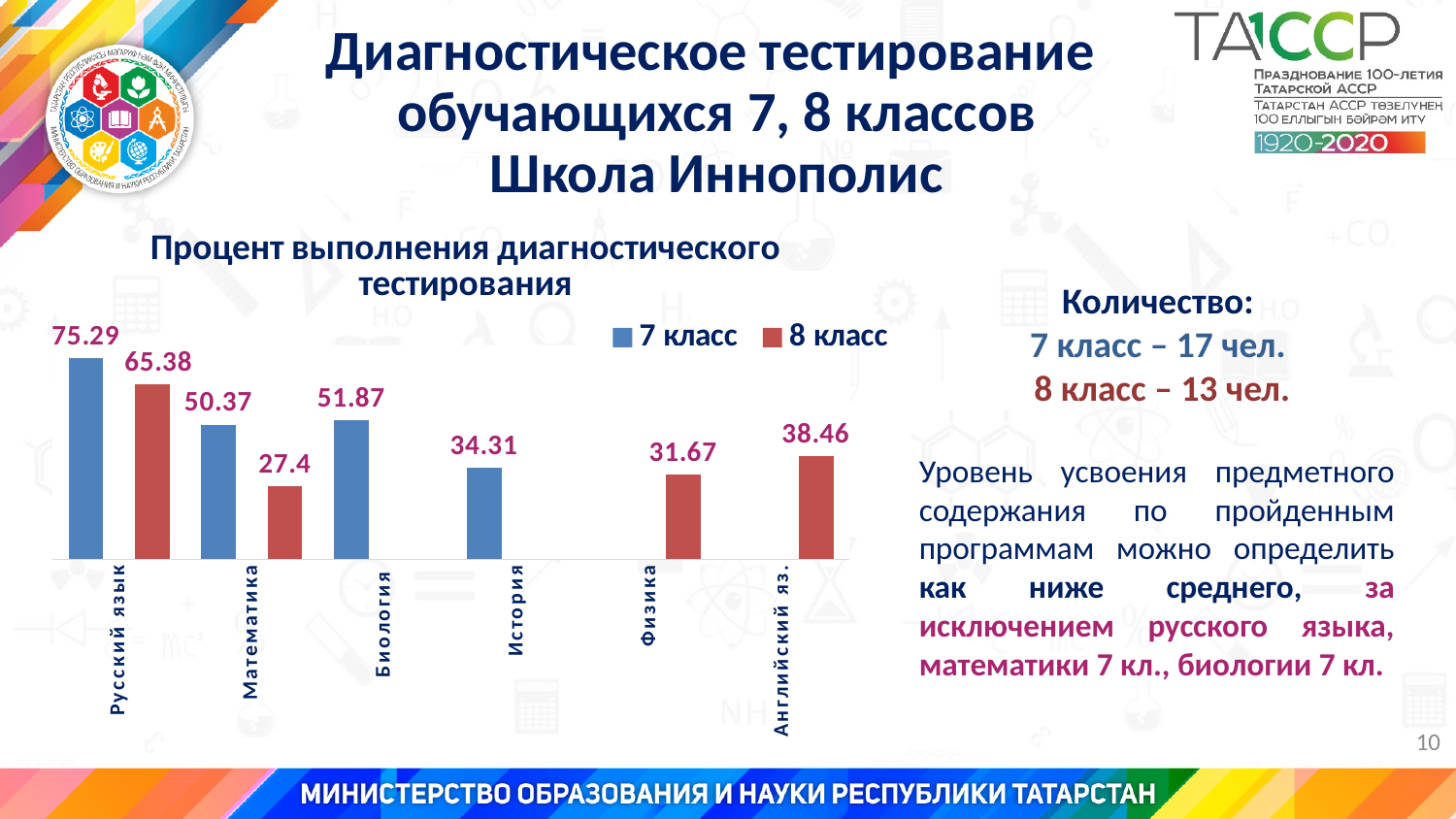
Which subject has the lowest value for 8 класс? Математика How many subject categories are shown on the x axis? 6 What is the difference between the 7 класс and 8 класс values in Математика? 22.97 What is the value for 8 класс in Английский яз.? 38.46 What is the value for 8 класс in Математика? 27.4 How many series does the legend list? 2 Which is larger: the 8 класс value in Физика or the 8 класс value in Английский яз.? Английский яз. What is the difference between the 7 класс and 8 класс values in Русский язык? 9.91 Which subject has the highest value for 7 класс? Русский язык What type of chart is shown? Bar chart What is the value for 7 класс in Биология? 51.87 What is the value for 7 класс in Русский язык? 75.29